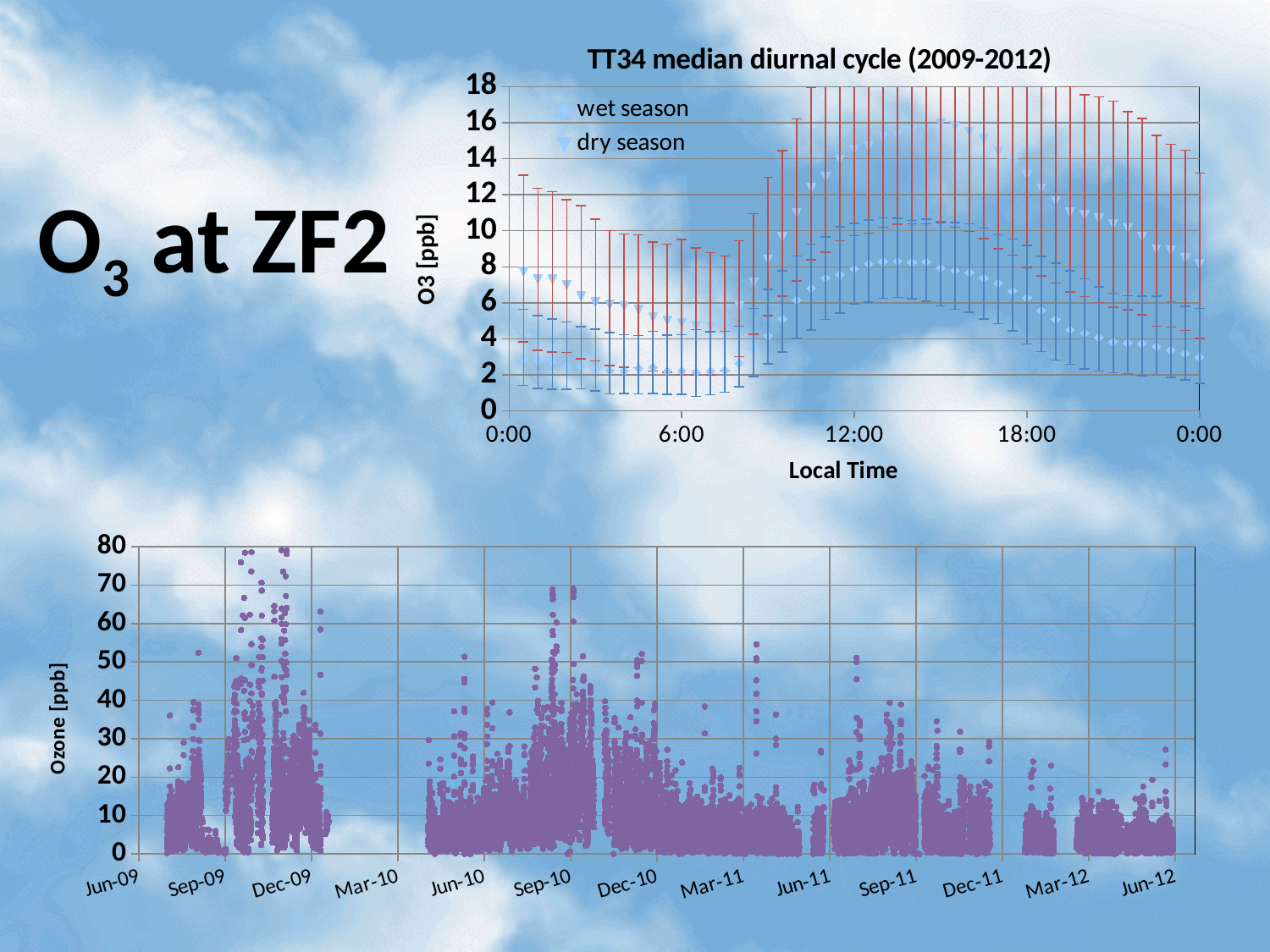
In the top chart, how many series does the legend list? 2 In the top chart, which series has the larger value at 12:00, wet season or dry season? dry season In the top chart, does the dry season series rise or fall between 6:00 and 12:00? rise In the top chart, what are the two series named in the legend? wet season and dry season What is the title of the top chart? TT34 median diurnal cycle (2009-2012) In the top chart, does the wet season series rise or fall between 0:00 and 6:00? fall What kind of chart is the bottom chart? scatter chart In the top chart, is the wet season value at 6:00 greater or less than 4? less In the top chart, is the dry season value at 18:00 greater or less than 10? greater In the bottom chart, are the ozone values around Jun-12 greater or less than 30? less